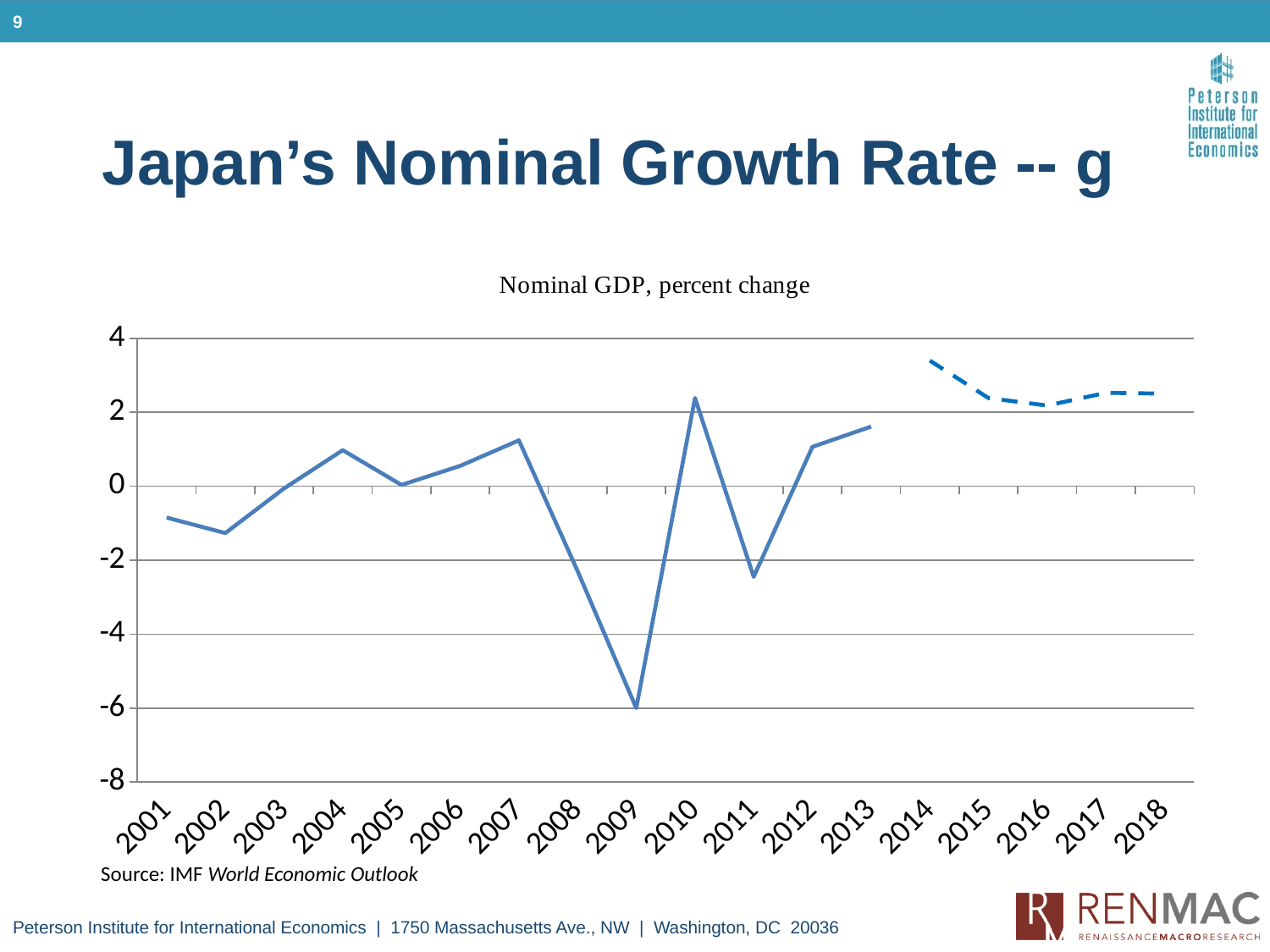
Is the value for 2010 greater or less than 2? greater Is the value for 2011 greater or less than -2? less Which year has the highest nominal GDP percent change in the chart? 2014 What kind of chart is shown on the slide? line chart Is the value for 2014 greater or less than 2? greater What is the title of the chart? Nominal GDP, percent change Which year has the lowest nominal GDP percent change in the chart? 2009 How many years are shown on the x axis of the chart? 18 Do the values rise or fall from 2008 to 2009? fall Which year has the larger value, 2010 or 2011? 2010 What source is cited below the chart? IMF World Economic Outlook